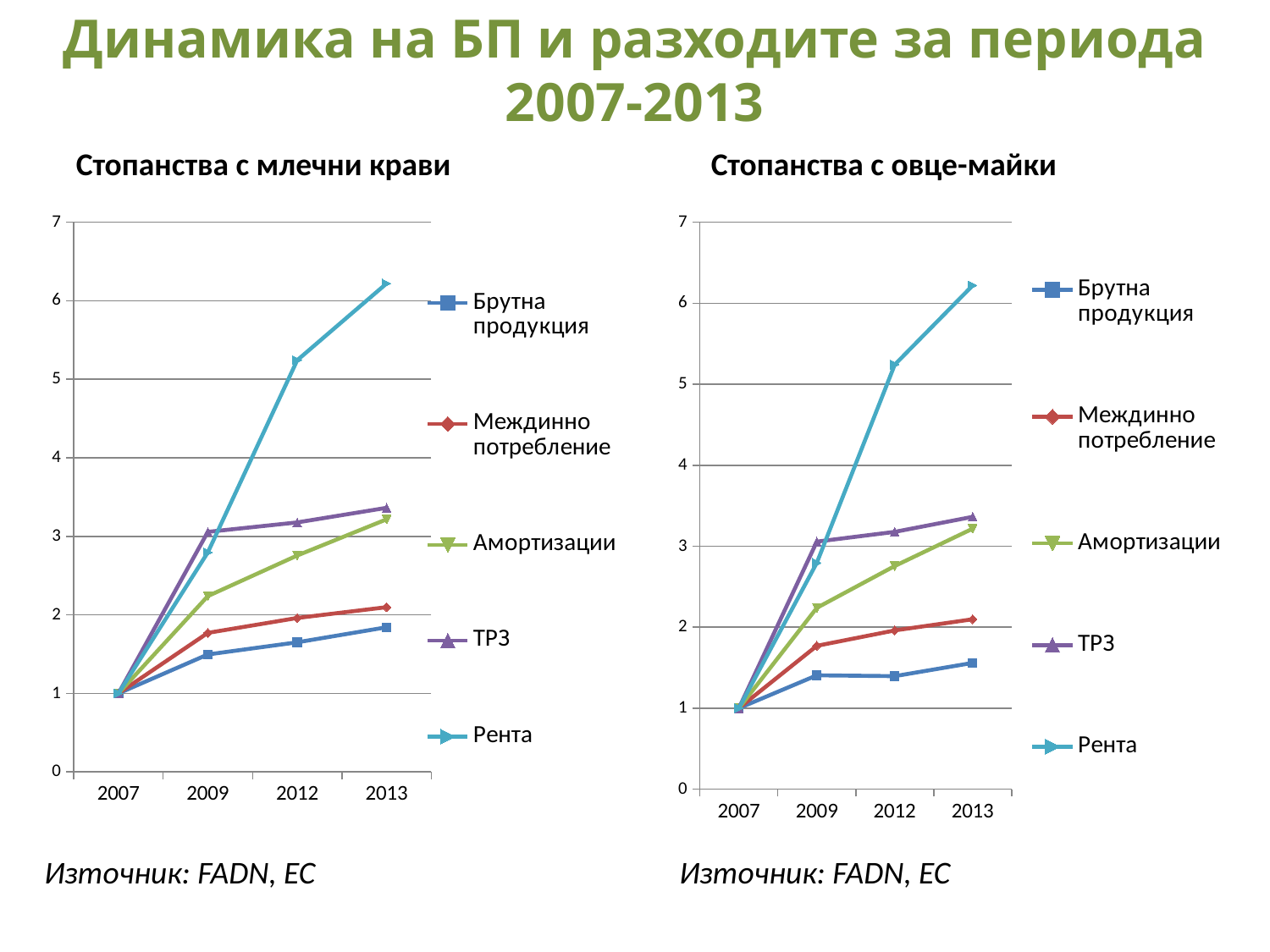
On the right chart (Стопанства с овце-майки), which series has the lowest value in 2013? Брутна продукция On the left chart (Стопанства с млечни крави), which series has the highest value in 2013? Рента On the right chart (Стопанства с овце-майки), does the Рента series rise or fall from 2007 to 2013? rise On the left chart (Стопанства с млечни крави), which series has the lowest value in 2013? Брутна продукция On the left chart (Стопанства с млечни крави), is the value for Рента in 2013 greater or less than 6? greater On the left chart (Стопанства с млечни крави), what type of chart is shown? line chart On the left chart (Стопанства с млечни крави), which is larger in 2013: ТРЗ or Амортизации? ТРЗ On the left chart (Стопанства с млечни крави), how many series does the legend list? 5 On the right chart (Стопанства с овце-майки), is the value for Брутна продукция in 2013 greater or less than 2? less On the right chart (Стопанства с овце-майки), is the value for Амортизации in 2012 greater or less than 3? less On the right chart (Стопанства с овце-майки), how many years are shown on the x axis? 4 On the left chart (Стопанства с млечни крави), what is the value of Рента in 2007? 1